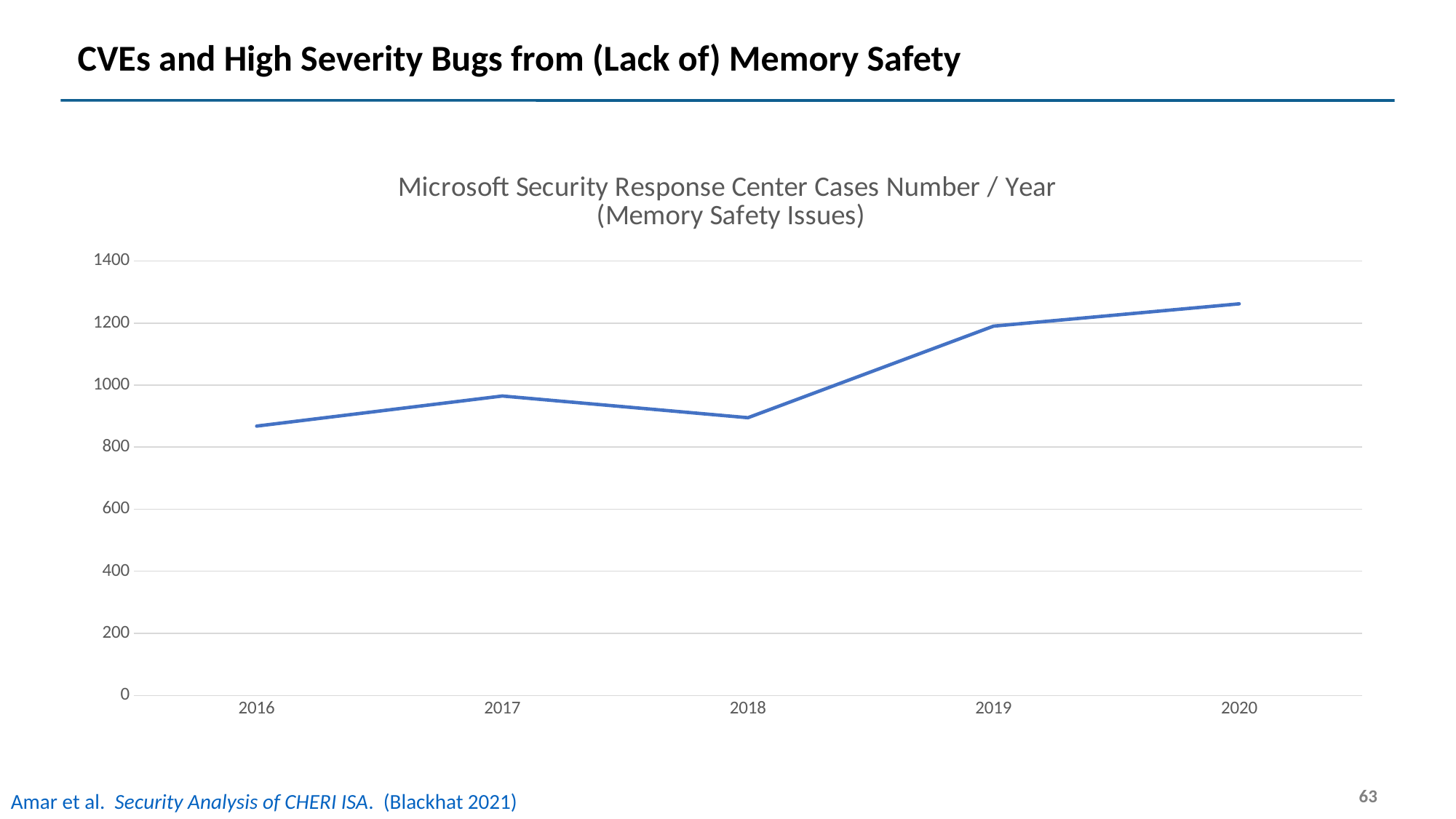
What kind of chart is shown on the slide? Line chart Which year has the highest number of cases in the chart? 2020 How many years are plotted on the x axis of the chart? 5 Overall, do the values rise or fall from 2016 to 2020? Rise Is the value for 2016 greater or less than 1000? less What is the title of the chart? Microsoft Security Response Center Cases Number / Year (Memory Safety Issues) Is the value for 2020 greater or less than 1200? greater Is the value for 2019 greater or less than 1000? greater Which year has the larger value, 2017 or 2018? 2017 Which year has the larger value, 2019 or 2020? 2020 Does the number of cases rise or fall between 2017 and 2018? Fall